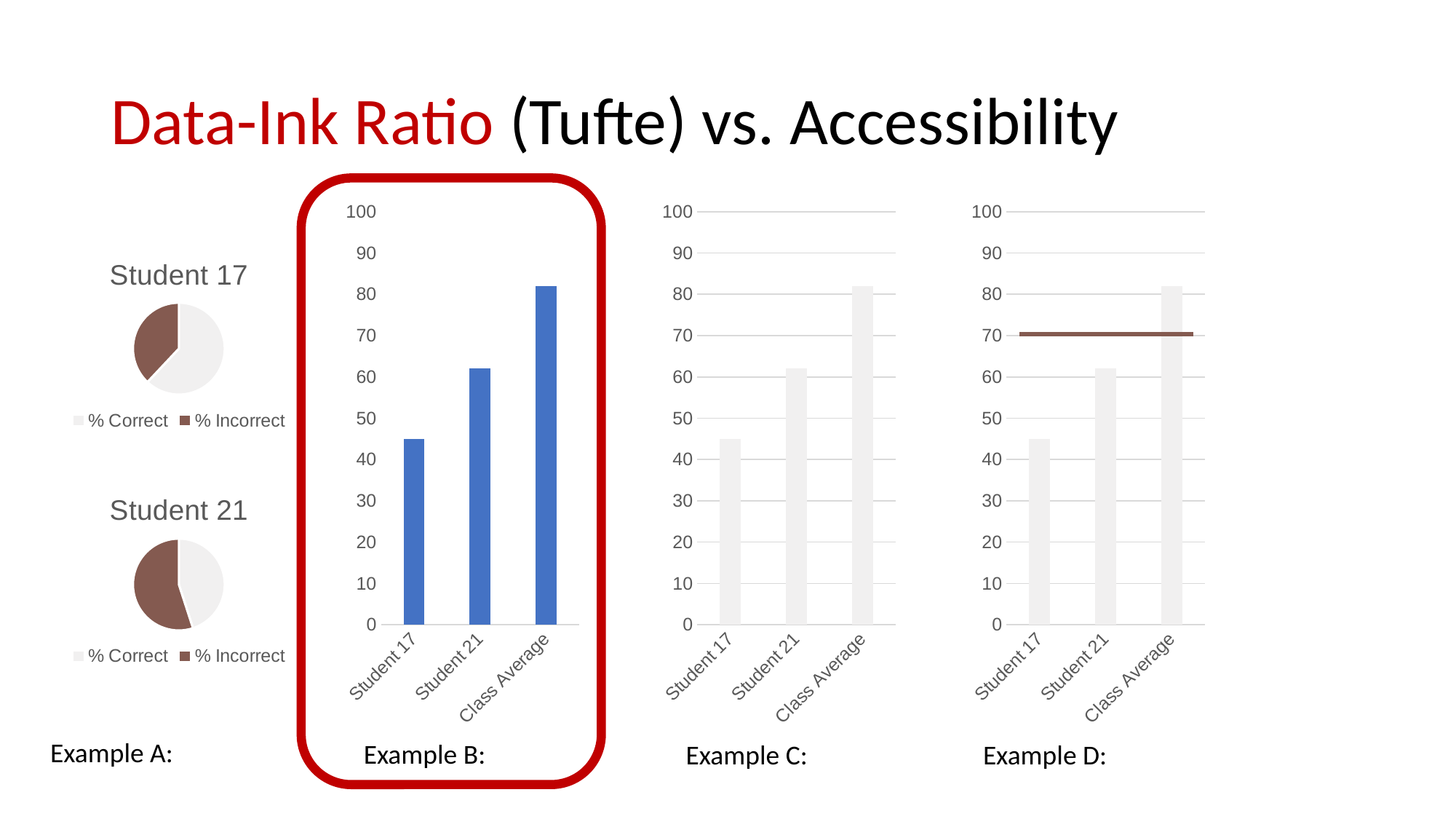
In Example C, is the value for Student 21 greater or less than 60? greater In Example C, which is larger, the bar for Student 21 or the bar for Class Average? Class Average In Example B, is the value for Class Average greater or less than 80? greater In Example D, do the bar values rise or fall from Student 17 to Class Average? rise In Example B, which category has the highest bar? Class Average In Example B, is the value for Student 17 greater or less than 50? less In Example B, which category has the lowest bar? Student 17 In Example D, at what axis value is the horizontal line drawn? 70 In Example D, how many bars are plotted? 3 In Example A, how many entries does the legend of the Student 17 pie chart list? 2 In Example A, what kind of charts are shown for Student 17 and Student 21? pie charts In Example B, what kind of chart is shown? bar chart